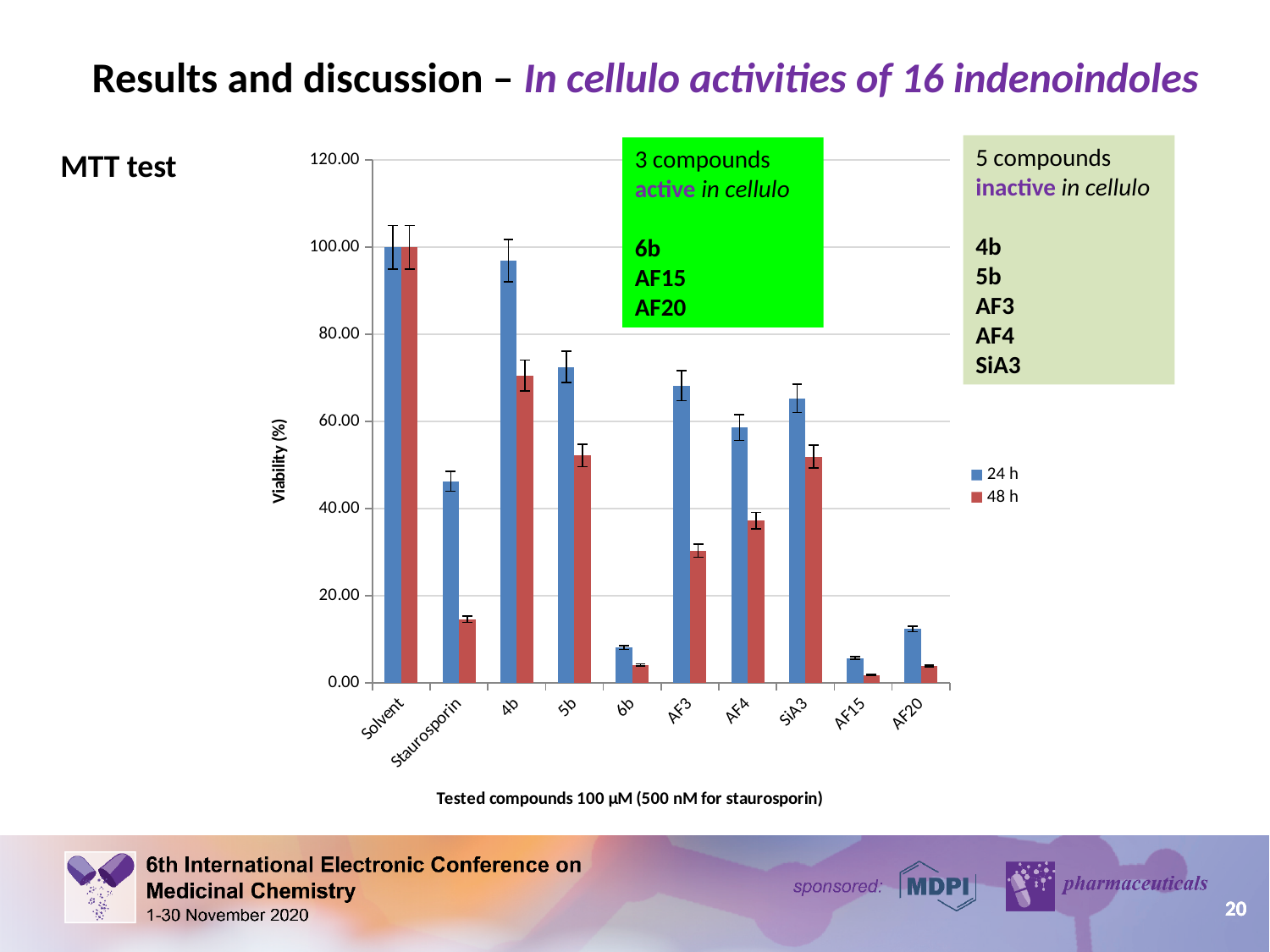
Is the 48 h viability for AF3 greater or less than 40.00? less What is the title of the y axis of the chart? Viability (%) What is the 24 h viability value for Solvent? 100.00 What are the two entries in the chart legend? 24 h and 48 h Is the 24 h viability for 6b greater or less than 20.00? less What kind of chart is shown on the slide? bar chart How many compounds (categories) are plotted along the x axis of the chart? 10 How many series does the chart legend list? 2 For AF3, which is larger, the 24 h value or the 48 h value? 24 h Is the 48 h viability for 4b greater or less than 60.00? greater Which has the larger 24 h viability, 4b or 5b? 4b